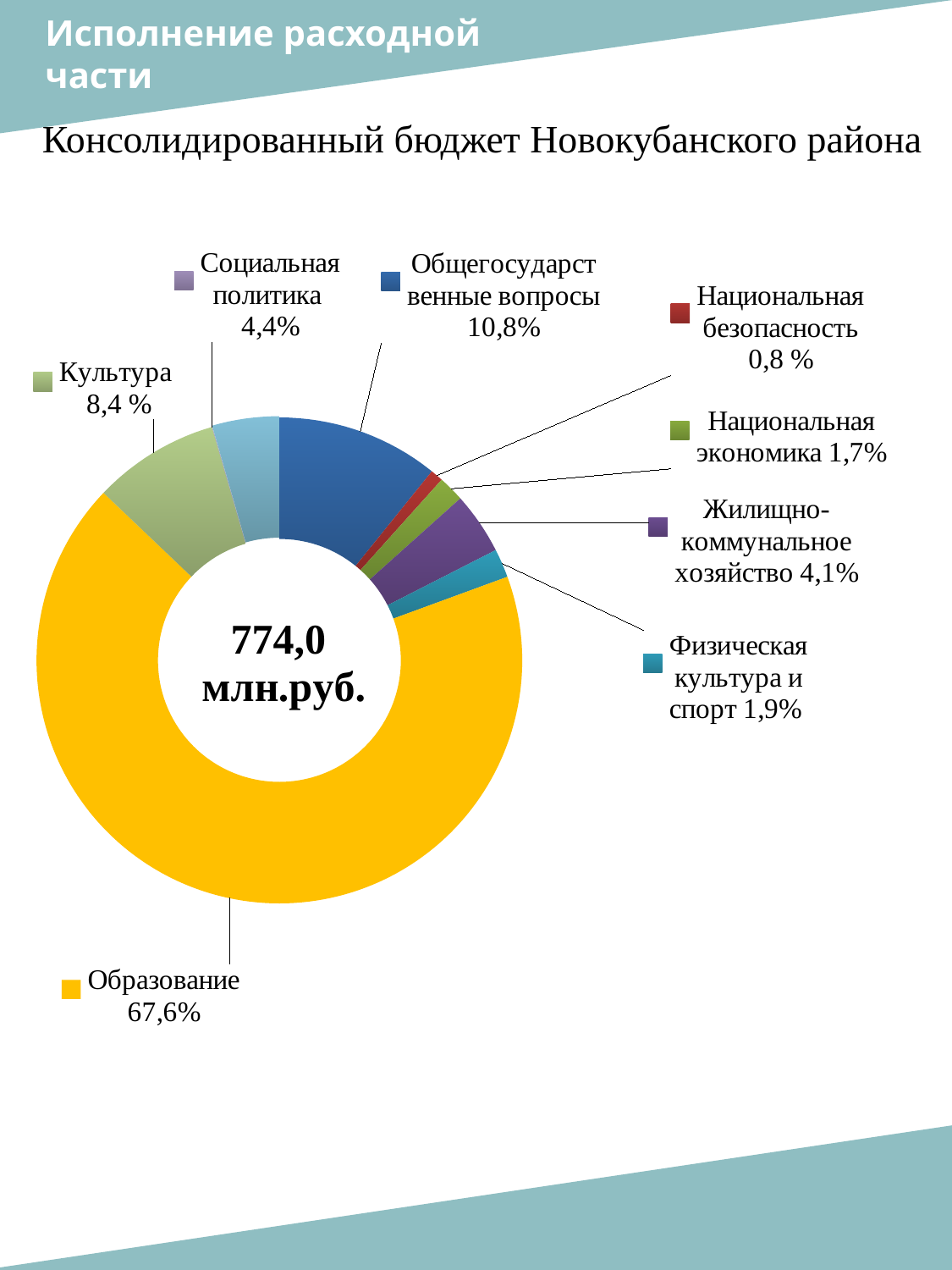
What share of the chart does Образование account for? 67,6% Which category has the smallest share of the chart? Национальная безопасность Which has a larger share: Физическая культура и спорт or Национальная экономика? Физическая культура и спорт What percentage is shown for Культура? 8,4 % What kind of chart is shown on the slide? Doughnut (pie) chart How many categories are shown in the chart? 8 What is the difference in percentage points between Общегосударственные вопросы and Культура? 2,4 What percentage is shown for Жилищно-коммунальное хозяйство? 4,1% Which category has the largest share of the chart? Образование What total amount is printed in the centre of the chart? 774,0 млн.руб. Which has a larger share: Социальная политика or Жилищно-коммунальное хозяйство? Социальная политика What percentage is shown for Общегосударственные вопросы? 10,8%